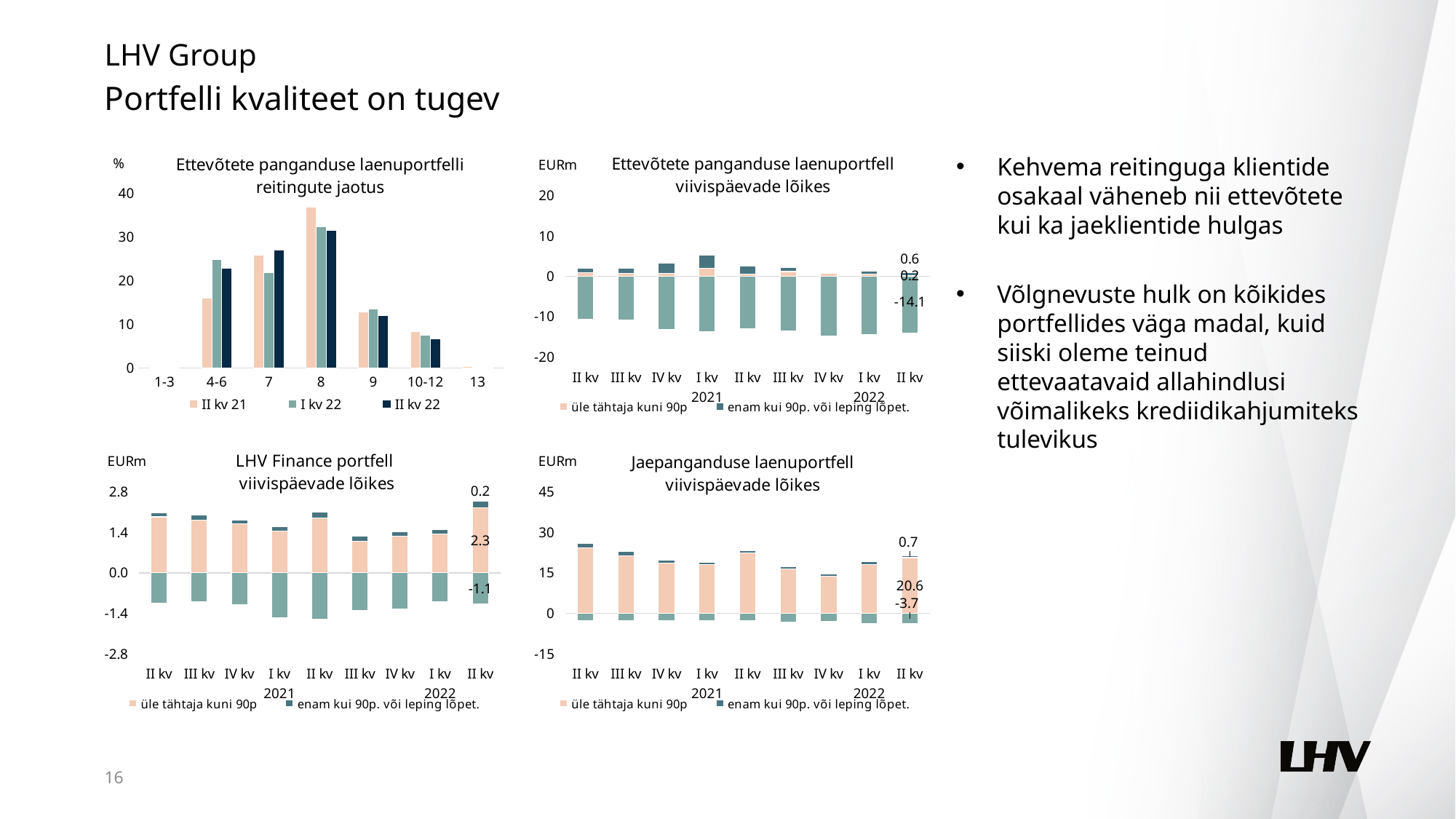
How many quarters are shown on the x axis of 'Jaepanganduse laenuportfell viivispäevade lõikes'? 9 How many rating categories are shown on the x axis of 'Ettevõtete panganduse laenuportfelli reitingute jaotus'? 7 What kind of chart is 'Ettevõtete panganduse laenuportfelli reitingute jaotus'? bar chart In 'Ettevõtete panganduse laenuportfelli reitingute jaotus', which rating category has the highest II kv 21 value? 8 In 'Ettevõtete panganduse laenuportfell viivispäevade lõikes', what value is labelled on the negative segment of the rightmost bar (II kv 2022)? -14.1 In 'Ettevõtete panganduse laenuportfelli reitingute jaotus', is the II kv 21 value for rating 8 greater or less than 30? greater In 'Jaepanganduse laenuportfell viivispäevade lõikes', what value is labelled for 'üle tähtaja kuni 90p' on the rightmost bar (II kv 2022)? 20.6 How many series does the legend of 'Ettevõtete panganduse laenuportfelli reitingute jaotus' list? 3 In 'LHV Finance portfell viivispäevade lõikes', what value is labelled for 'üle tähtaja kuni 90p' on the rightmost bar (II kv 2022)? 2.3 In 'LHV Finance portfell viivispäevade lõikes', what value is labelled on the negative segment of the rightmost bar (II kv 2022)? -1.1 In 'Ettevõtete panganduse laenuportfelli reitingute jaotus', for rating 4-6, which is larger: II kv 21 or II kv 22? II kv 22 In 'Jaepanganduse laenuportfell viivispäevade lõikes', what value is labelled on the negative segment of the rightmost bar (II kv 2022)? -3.7